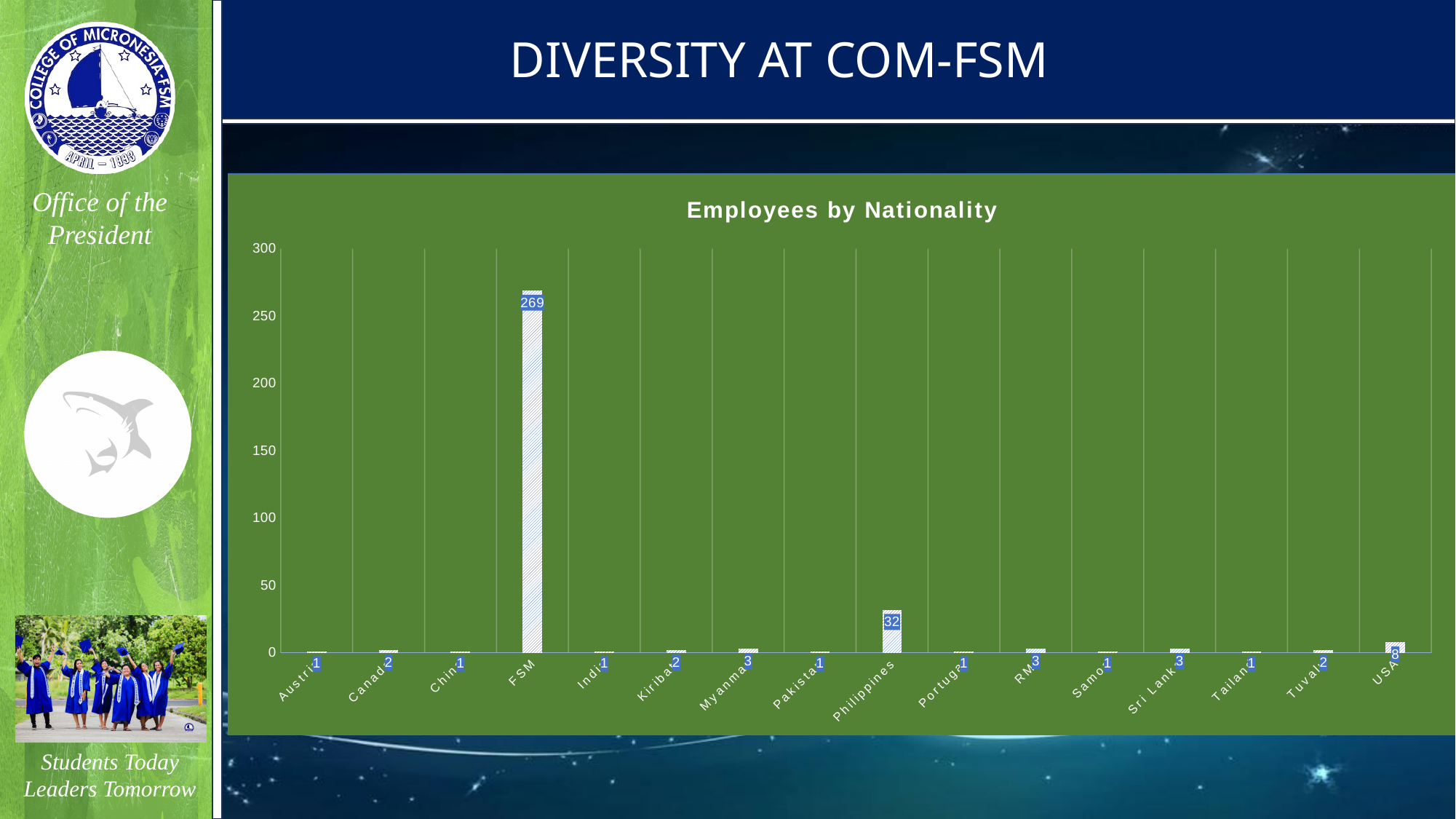
How many employees are from the USA? 8 Is the value for FSM greater or less than 250? greater Which nationality has the highest number of employees? FSM How many employees are from the Philippines? 32 How many nationality categories are shown on the x axis? 16 How many employees are from RMI? 3 How many employees are from Kiribati? 2 What kind of chart is shown on the slide? bar chart How many employees are from FSM? 269 What is the title of the chart? Employees by Nationality What is the difference between the number of employees from FSM and from the Philippines? 237 Which has more employees, the Philippines or the USA? Philippines